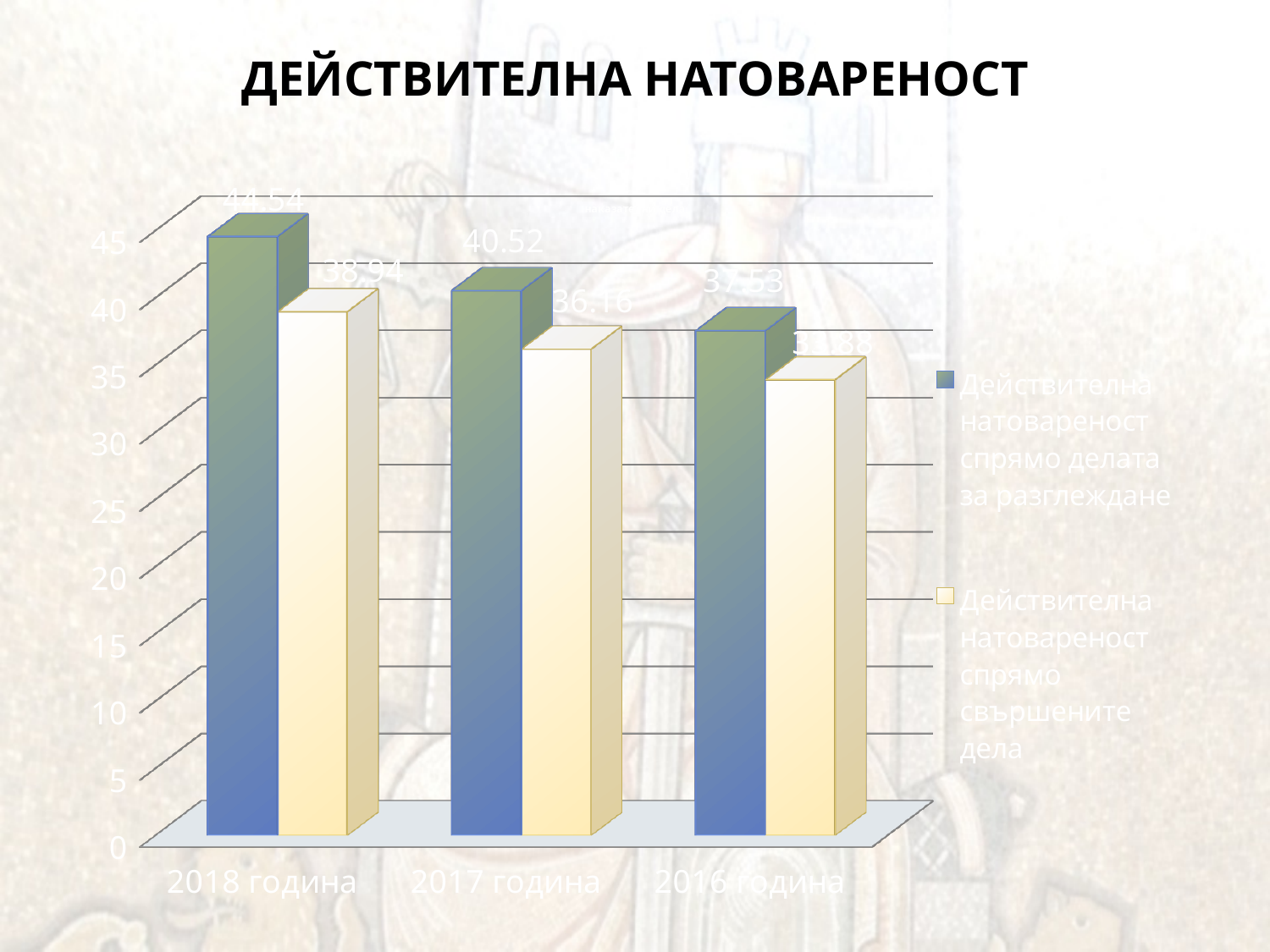
What is the value of 'Действителна натовареност спрямо свършените дела' for 2018 година? 38.94 How many year categories are shown on the x axis? 3 How many series does the legend list? 2 What is the value of 'Действителна натовареност спрямо свършените дела' for 2017 година? 36.16 What is the value of 'Действителна натовареност спрямо делата за разглеждане' for 2018 година? 44.54 What is the value of 'Действителна натовареност спрямо делата за разглеждане' for 2016 година? 37.53 What kind of chart is shown on the slide? bar chart What is the value of 'Действителна натовареност спрямо делата за разглеждане' for 2017 година? 40.52 Which year has the highest value for 'Действителна натовареност спрямо делата за разглеждане'? 2018 година Is the value of 'Действителна натовареност спрямо свършените дела' for 2016 година greater or less than 35? less Do the values of 'Действителна натовареност спрямо делата за разглеждане' rise or fall from 2018 година to 2016 година along the x axis? fall What is the difference between the two series' values for 2018 година? 5.60